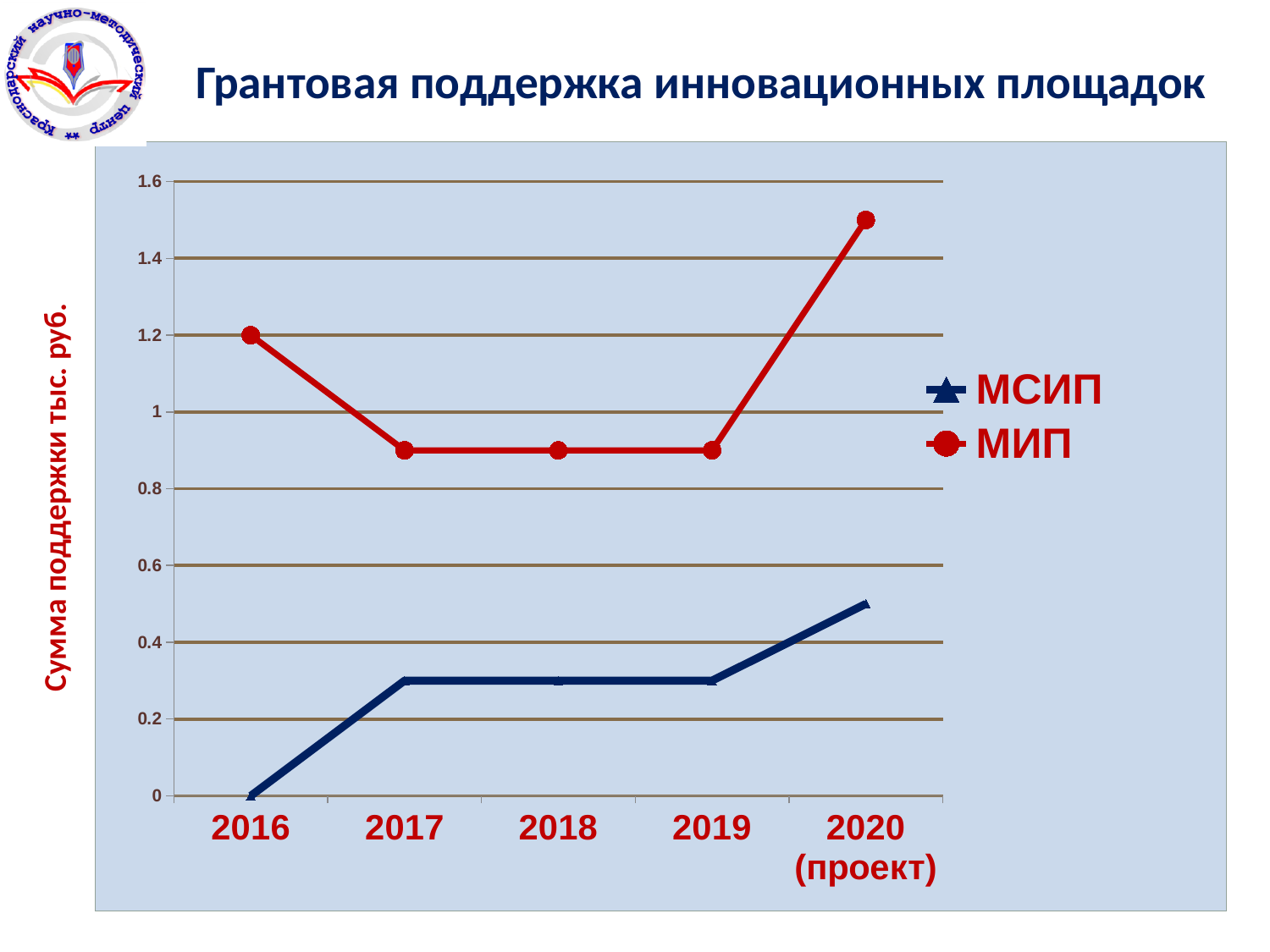
How many years are shown on the x axis? 5 Which series has the larger value in 2019, МСИП or МИП? МИП In which year does the МСИП series have its lowest value? 2016 What is the value for МИП in 2016? 1.2 Is the value for МИП in 2018 greater or less than 1? less In which year does the МИП series reach its highest value? 2020 (проект) What is the value for МСИП in 2016? 0 How many series does the legend list? 2 What is the label of the vertical axis? Сумма поддержки тыс. руб. What kind of chart is shown on the slide? line chart Is the value for МСИП in 2020 (проект) greater or less than 0.4? greater Is the value for МИП in 2020 (проект) greater or less than 1.4? greater